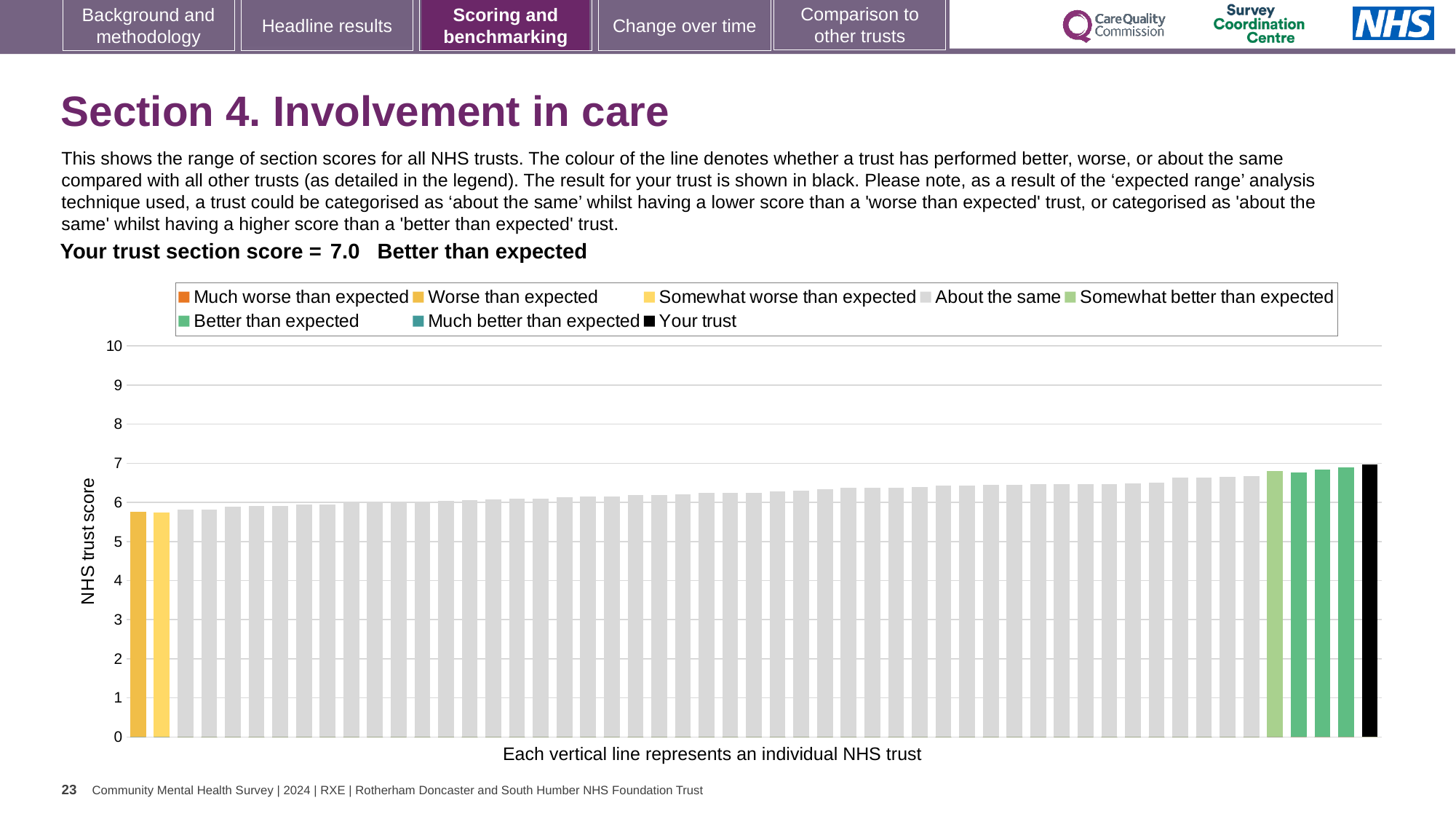
What is the title of the vertical axis? NHS trust score Is the value of the lowest bar greater or less than 5? greater Is the value for your trust greater or less than 6? greater How many entries does the chart legend list? 8 Which performance category is your trust's section score placed in? Better than expected Is the value of the highest bar greater or less than 8? less What is the section score for your trust? 7.0 Do the bar values rise or fall from left to right along the x axis? rise Which legend category does the tallest bar belong to? Your trust Which legend category does the black bar represent? Your trust What kind of chart is shown on the slide? bar chart